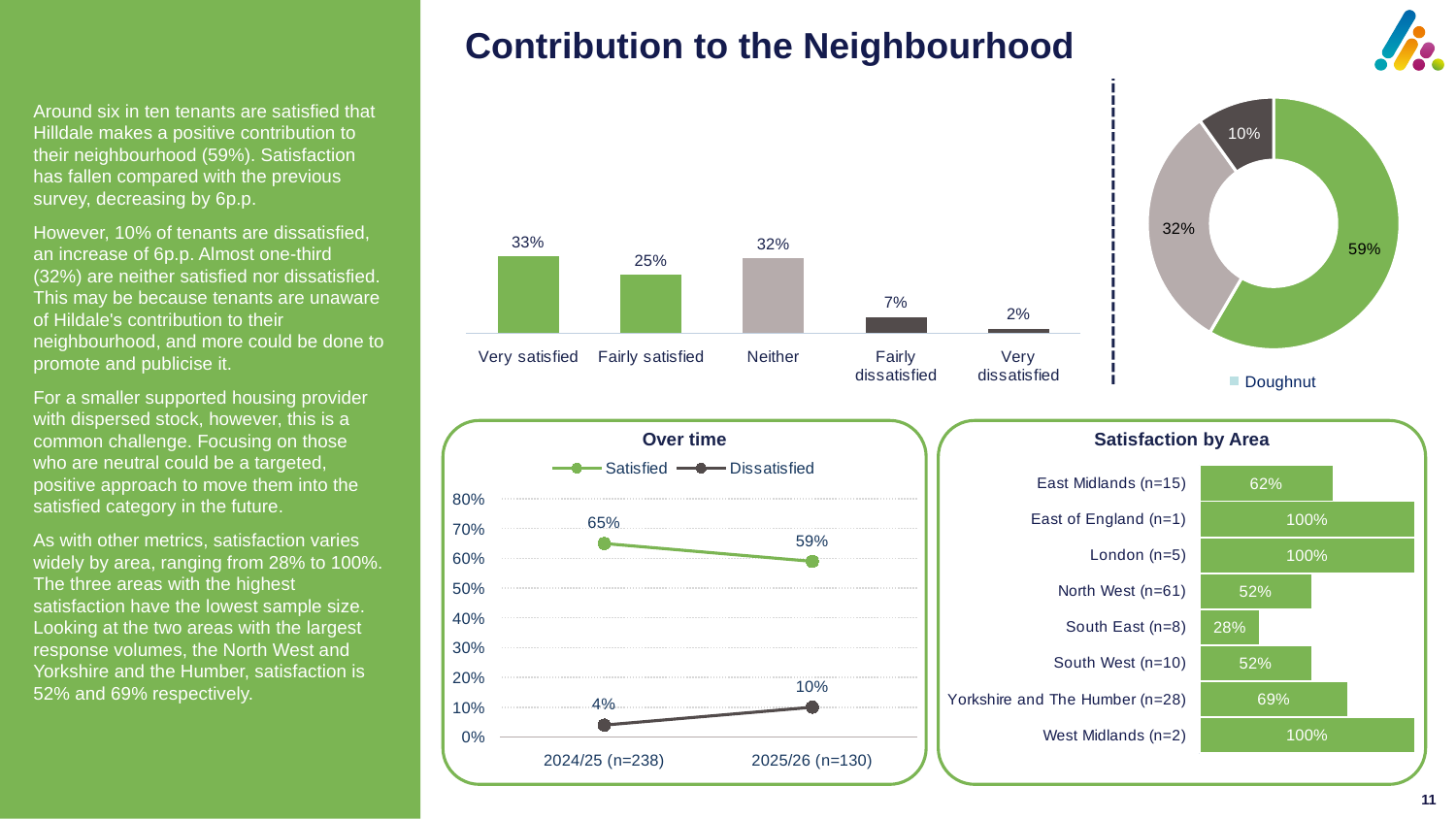
In the bar chart at the top centre of the slide, what is the difference between Fairly satisfied and Fairly dissatisfied? 18% What kind of chart is the Satisfaction by Area chart? bar chart In the Satisfaction by Area chart, which area has the lowest satisfaction? South East (n=8) In the bar chart at the top centre of the slide, what is the value for Very satisfied? 33% In the doughnut chart at the top right, what is the value of the dark grey slice? 10% In the bar chart at the top centre of the slide, how many categories are shown? 5 In the Over time chart, what is the Satisfied value for 2025/26 (n=130)? 59% In the Satisfaction by Area chart, what is the value for North West (n=61)? 52% In the doughnut chart at the top right, what is the largest slice's value? 59% In the Over time chart, does the Dissatisfied series rise or fall from 2024/25 to 2025/26? rise In the bar chart at the top centre of the slide, which category has the lowest value? Very dissatisfied In the Over time chart, how many series does the legend list? 2